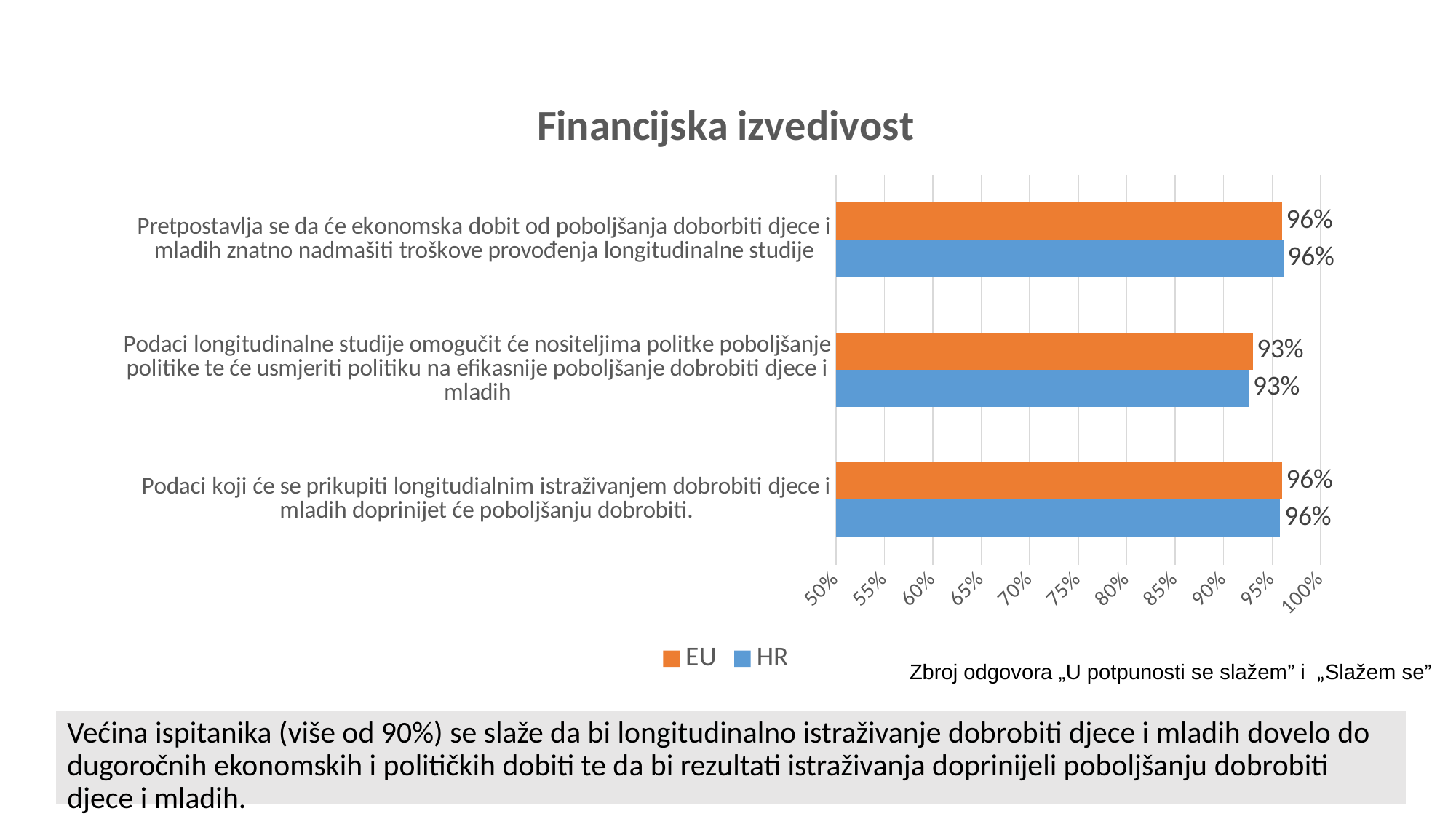
What is the difference between the EU value for the top category (96%) and the EU value for the middle category (93%)? 3% Is the EU value for the top category larger than, smaller than, or equal to the HR value for the same category? equal Which category has the lowest EU value? Podaci longitudinalne studije omogučit će nositeljima politke poboljšanje politike te će usmjeriti politiku na efikasnije poboljšanje dobrobiti djece i mladih What is the EU value for the statement 'Podaci longitudinalne studije omogučit će nositeljima politke poboljšanje politike...' (the middle category)? 93% What type of chart is shown on the slide? bar chart How many categories (statements) are plotted in the chart? 3 How many series does the legend list? 2 What is the HR value for the top category, 'Pretpostavlja se da će ekonomska dobit od poboljšanja doborbiti djece i mladih znatno nadmašiti troškove provođenja longitudinalne studije'? 96% What is the HR value for the bottom category, 'Podaci koji će se prikupiti longitudialnim istraživanjem dobrobiti djece i mladih doprinijet će poboljšanju dobrobiti.'? 96% Is the HR value for the middle category greater or less than 90%? greater Which series is shown in orange in the legend? EU What is the title of the chart? Financijska izvedivost